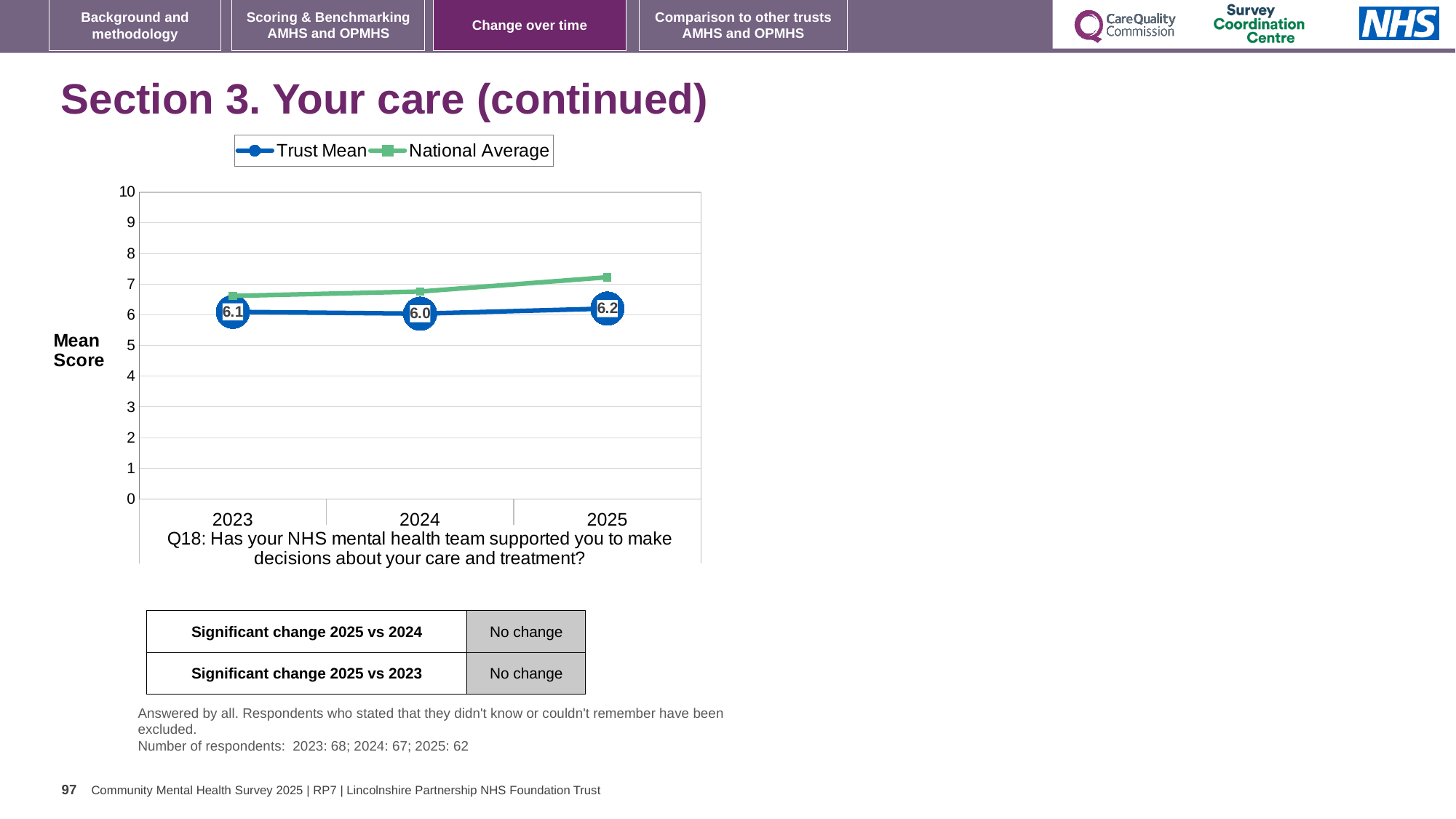
What is the Trust Mean score for 2025? 6.2 Which is larger, the Trust Mean in 2025 or in 2023? 2025 What is the Trust Mean score for 2024? 6.0 Is the National Average value for 2023 greater or less than 6? greater Is the National Average value for 2025 greater or less than 7? greater In which year is the Trust Mean highest? 2025 What is the Trust Mean score for 2023? 6.1 What kind of chart is shown? Line chart What is the difference between the Trust Mean in 2025 and in 2024? 0.2 How many years are plotted on the x axis? 3 In which year is the Trust Mean lowest? 2024 How many series does the legend list? 2